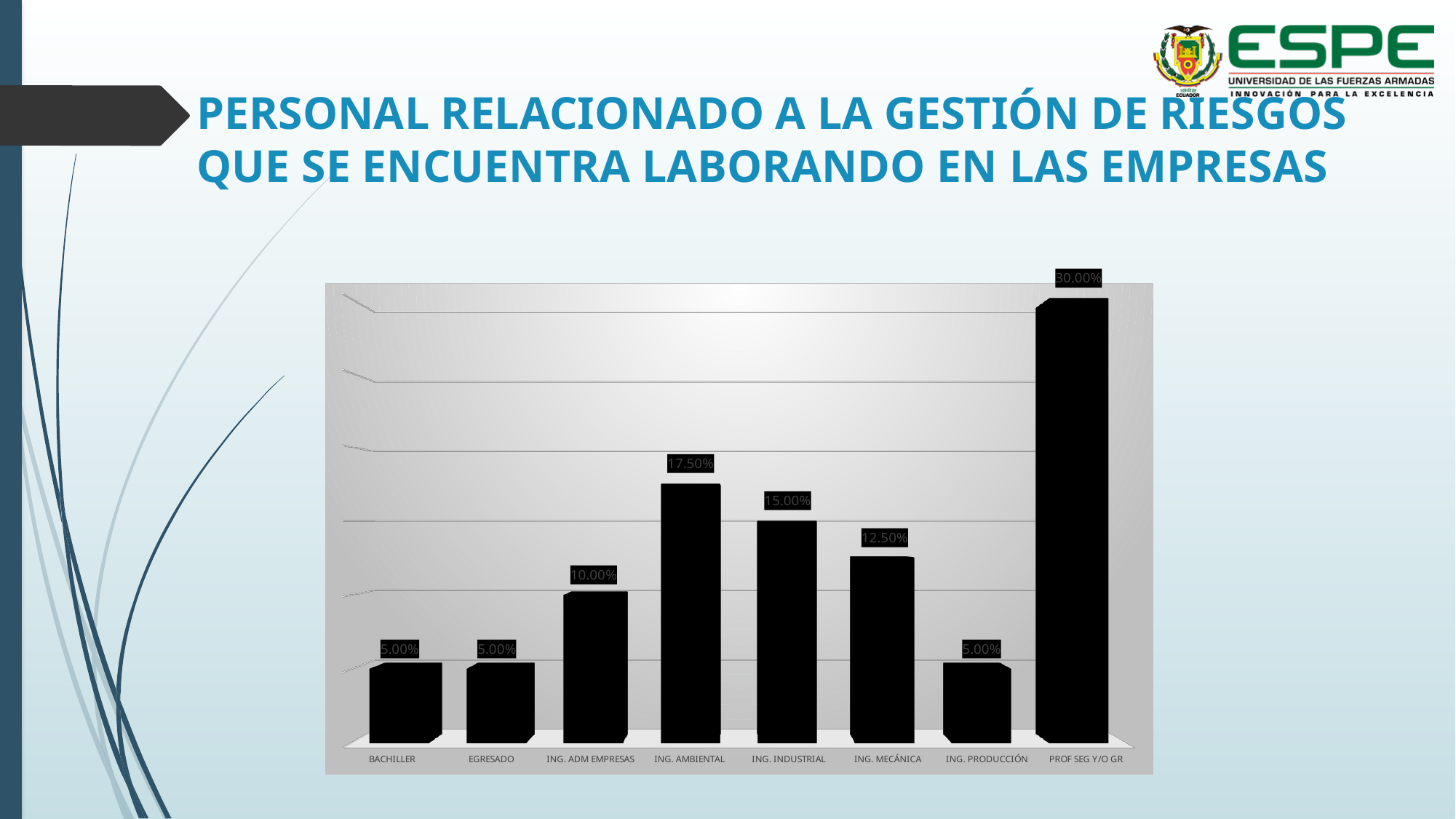
What is the difference between the values for ING. INDUSTRIAL and ING. MECÁNICA? 2.50% What is the difference between the values for PROF SEG Y/O GR and ING. AMBIENTAL? 12.50% Which category has the highest value? PROF SEG Y/O GR How many categories have a value of 5.00%? 3 What kind of chart is shown on the slide? bar chart What is the value for ING. INDUSTRIAL? 15.00% What is the value for ING. AMBIENTAL? 17.50% What is the value for ING. MECÁNICA? 12.50% How many categories are shown on the x axis? 8 Which is larger, the value for ING. INDUSTRIAL or the value for ING. ADM EMPRESAS? ING. INDUSTRIAL What is the value for PROF SEG Y/O GR? 30.00% What is the value for ING. ADM EMPRESAS? 10.00%